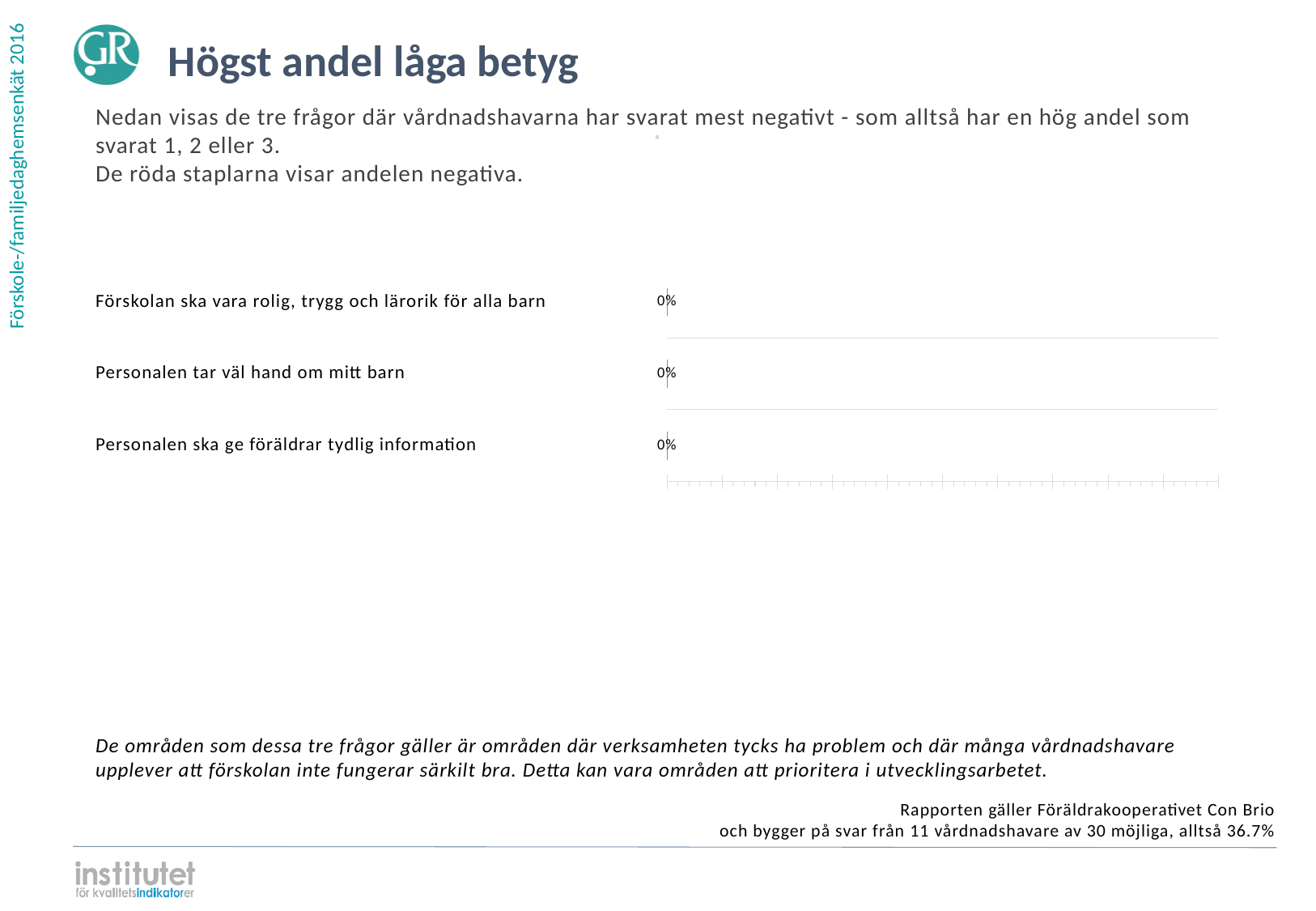
How many categories (questions) are plotted in the chart? 3 What value is shown for "Förskolan ska vara rolig, trygg och lärorik för alla barn"? 0% What kind of chart is shown on the slide? Bar chart What value is shown for "Personalen ska ge föräldrar tydlig information"? 0% What value is shown for "Personalen tar väl hand om mitt barn"? 0% What is the title of the slide containing the chart? Högst andel låga betyg What is the difference between the values for "Personalen tar väl hand om mitt barn" and "Personalen ska ge föräldrar tydlig information"? 0% According to the slide text, what do the red bars show? Andelen negativa Is the value for "Förskolan ska vara rolig, trygg och lärorik för alla barn" greater or less than 50%? less